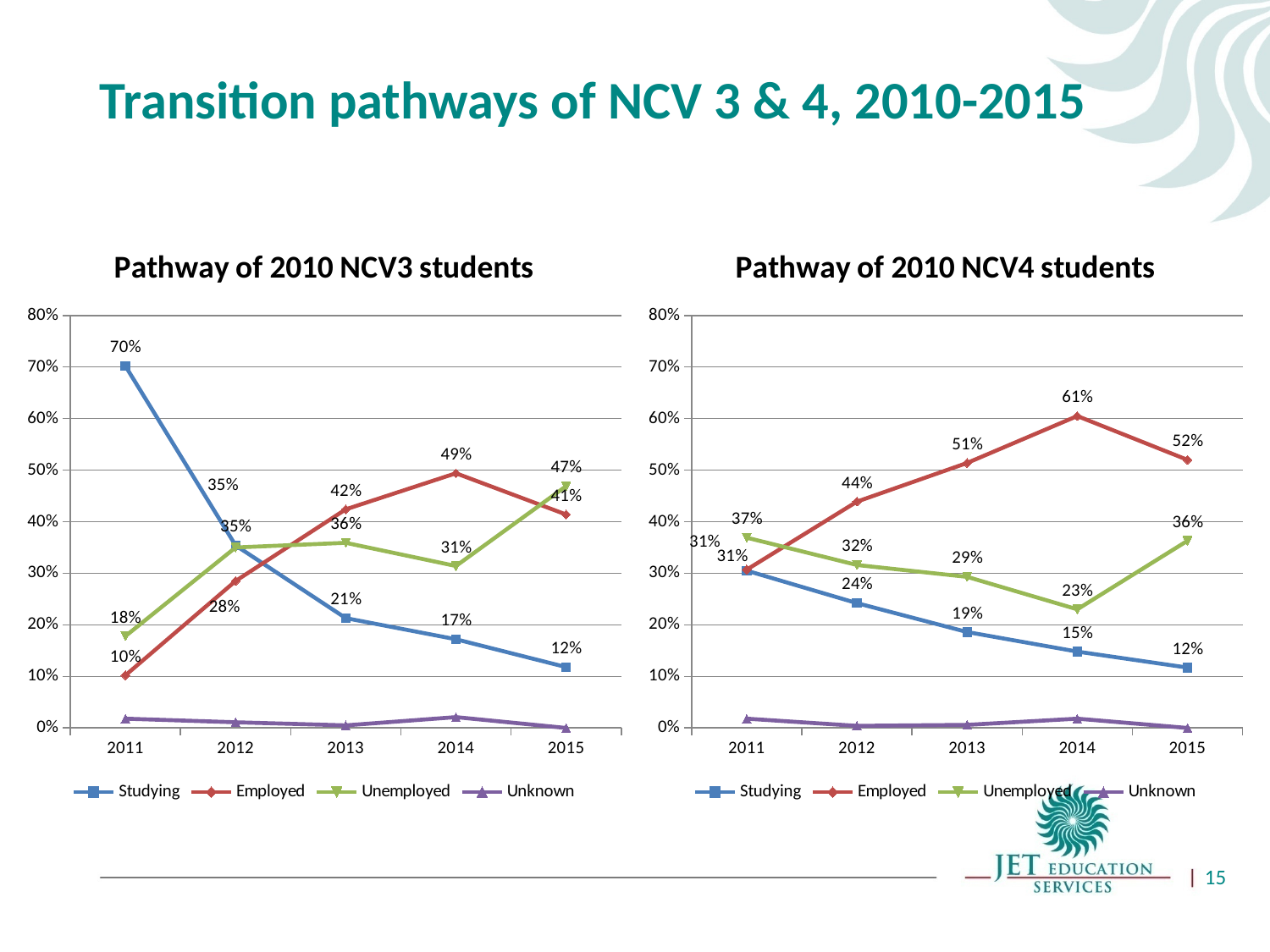
What kind of chart is the 'Pathway of 2010 NCV4 students' chart? Line chart How many years are shown on the x axis of the 'Pathway of 2010 NCV3 students' chart? 5 In the 'Pathway of 2010 NCV4 students' chart, what is the Unemployed value for 2013? 29% In the 'Pathway of 2010 NCV4 students' chart, what is the Employed value for 2014? 61% In the 'Pathway of 2010 NCV4 students' chart, which is larger in 2015, Employed or Unemployed? Employed In the 'Pathway of 2010 NCV3 students' chart, what is the Employed value for 2014? 49% In the 'Pathway of 2010 NCV3 students' chart, by how many percentage points did the Studying value fall from 2011 to 2015? 58 percentage points How many series does the legend of the 'Pathway of 2010 NCV3 students' chart list? 4 In the 'Pathway of 2010 NCV4 students' chart, does the Studying series rise or fall from 2011 to 2015? Fall In the 'Pathway of 2010 NCV4 students' chart, what is the difference between the Employed values for 2014 and 2015? 9 percentage points In the 'Pathway of 2010 NCV3 students' chart, what percentage of students were Studying in 2011? 70% In the 'Pathway of 2010 NCV3 students' chart, in which year is the Unemployed value highest? 2015